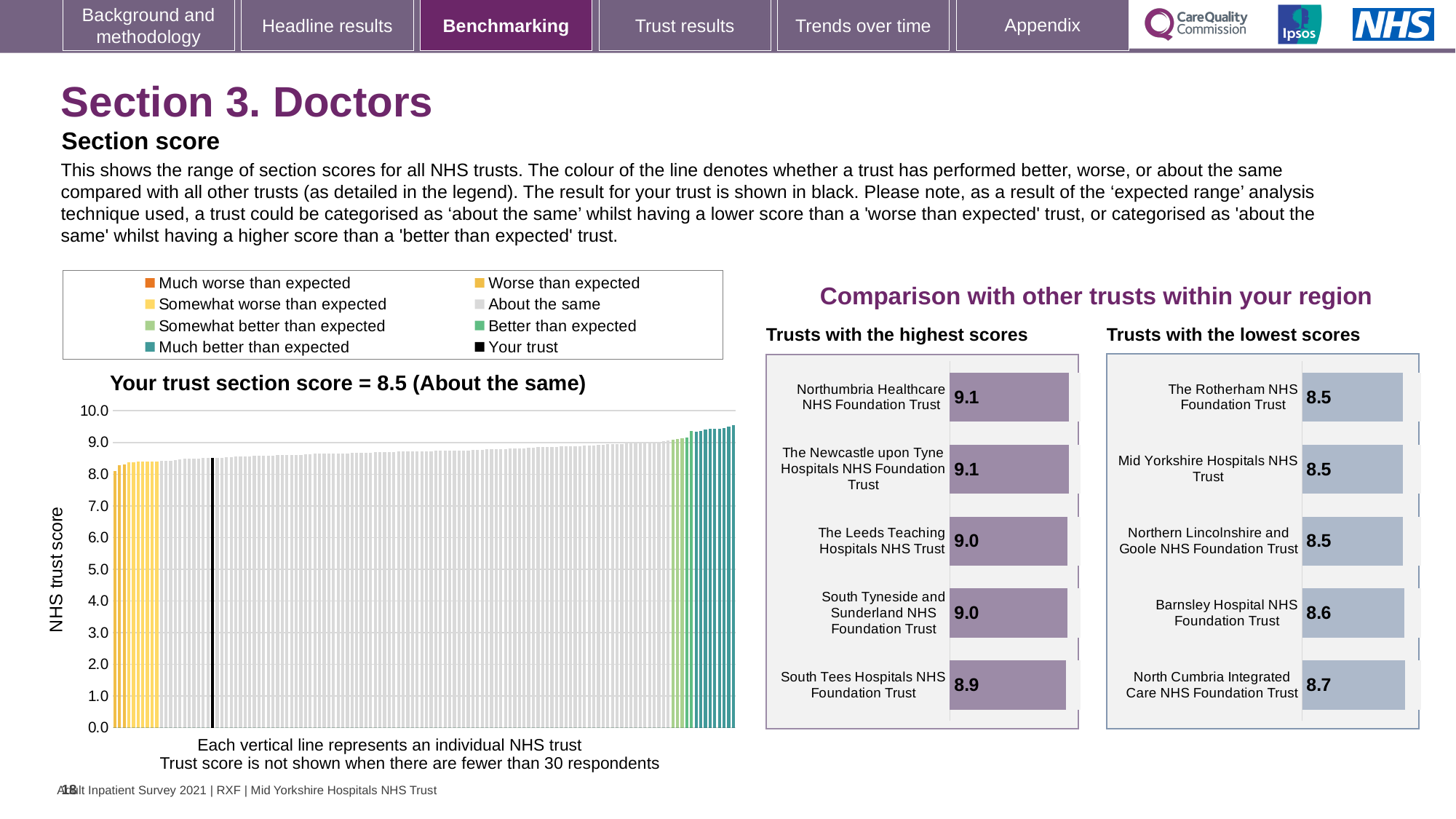
In the main chart on the left showing all NHS trusts, what is your trust's section score? 8.5 In the 'Trusts with the lowest scores' chart, what is the score for Barnsley Hospital NHS Foundation Trust? 8.6 In the 'Trusts with the highest scores' chart, what is the difference between the scores of Northumbria Healthcare NHS Foundation Trust and South Tees Hospitals NHS Foundation Trust? 0.2 In the 'Trusts with the highest scores' chart, what is the score for South Tees Hospitals NHS Foundation Trust? 8.9 In the 'Trusts with the highest scores' chart, how many trusts are listed? 5 In the 'Trusts with the lowest scores' chart, which has the larger score: Barnsley Hospital NHS Foundation Trust or North Cumbria Integrated Care NHS Foundation Trust? North Cumbria Integrated Care NHS Foundation Trust In the 'Trusts with the highest scores' chart, what is the score for Northumbria Healthcare NHS Foundation Trust? 9.1 How many entries does the legend above the main chart on the left list? 8 What kind of chart is the main chart on the left showing all NHS trusts? bar chart In the 'Trusts with the highest scores' chart, which trust has the lowest score? South Tees Hospitals NHS Foundation Trust In the 'Trusts with the lowest scores' chart, what is the score for North Cumbria Integrated Care NHS Foundation Trust? 8.7 In the 'Trusts with the lowest scores' chart, which trust has the highest score? North Cumbria Integrated Care NHS Foundation Trust